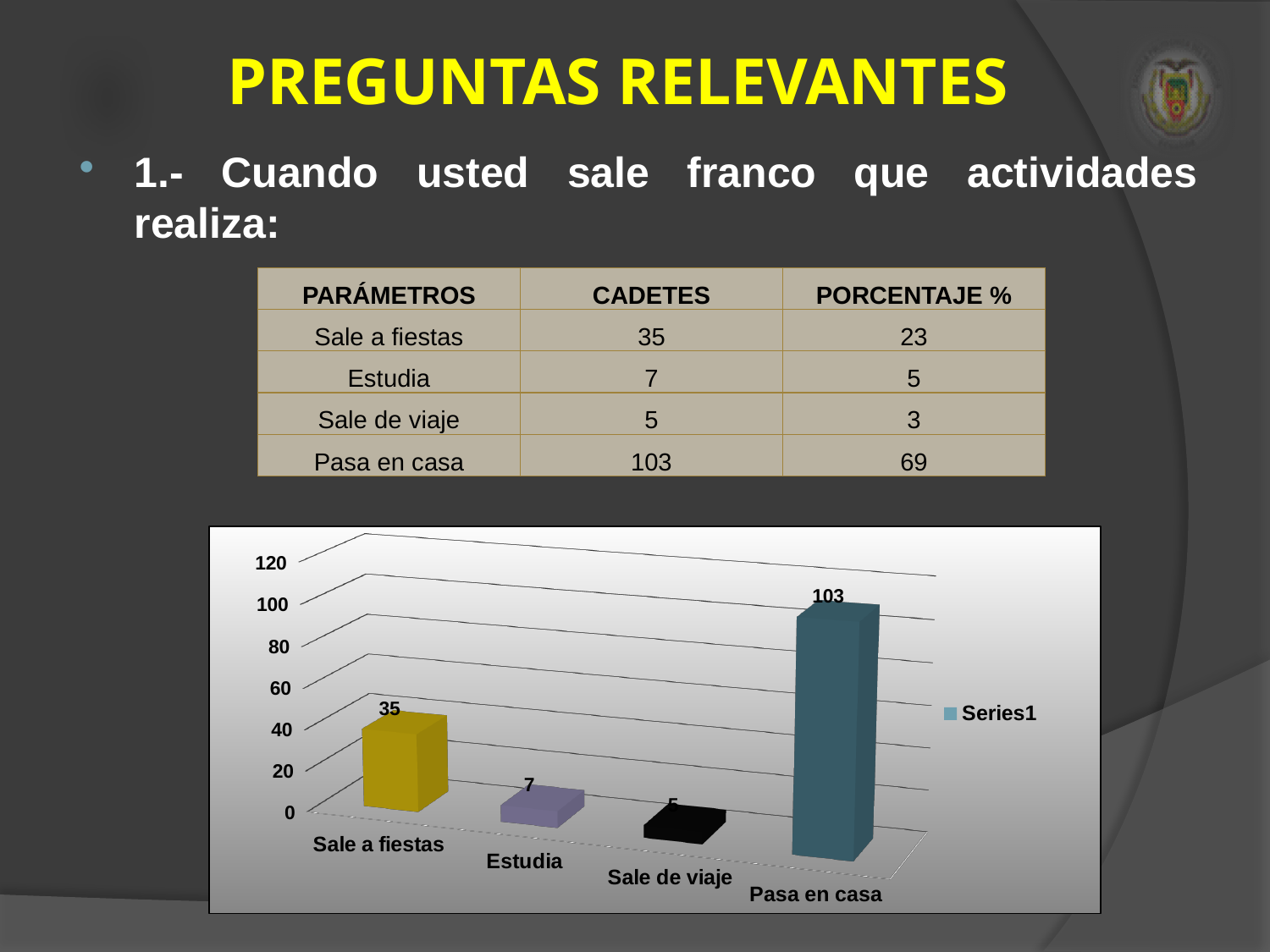
What is the name of the series shown in the chart legend? Series1 What kind of chart is shown on the slide? bar chart How many series does the chart legend list? 1 What is the difference between the values for Pasa en casa and Sale a fiestas? 68 Which is larger, the value for Sale a fiestas or the value for Estudia? Sale a fiestas What is the value for Estudia in the chart? 7 Is the value for Pasa en casa greater or less than 100? greater What is the value for Sale a fiestas in the chart? 35 How many categories are shown on the x axis of the chart? 4 Which category has the lowest value in the chart? Sale de viaje What is the value for Pasa en casa in the chart? 103 Which category has the highest value in the chart? Pasa en casa